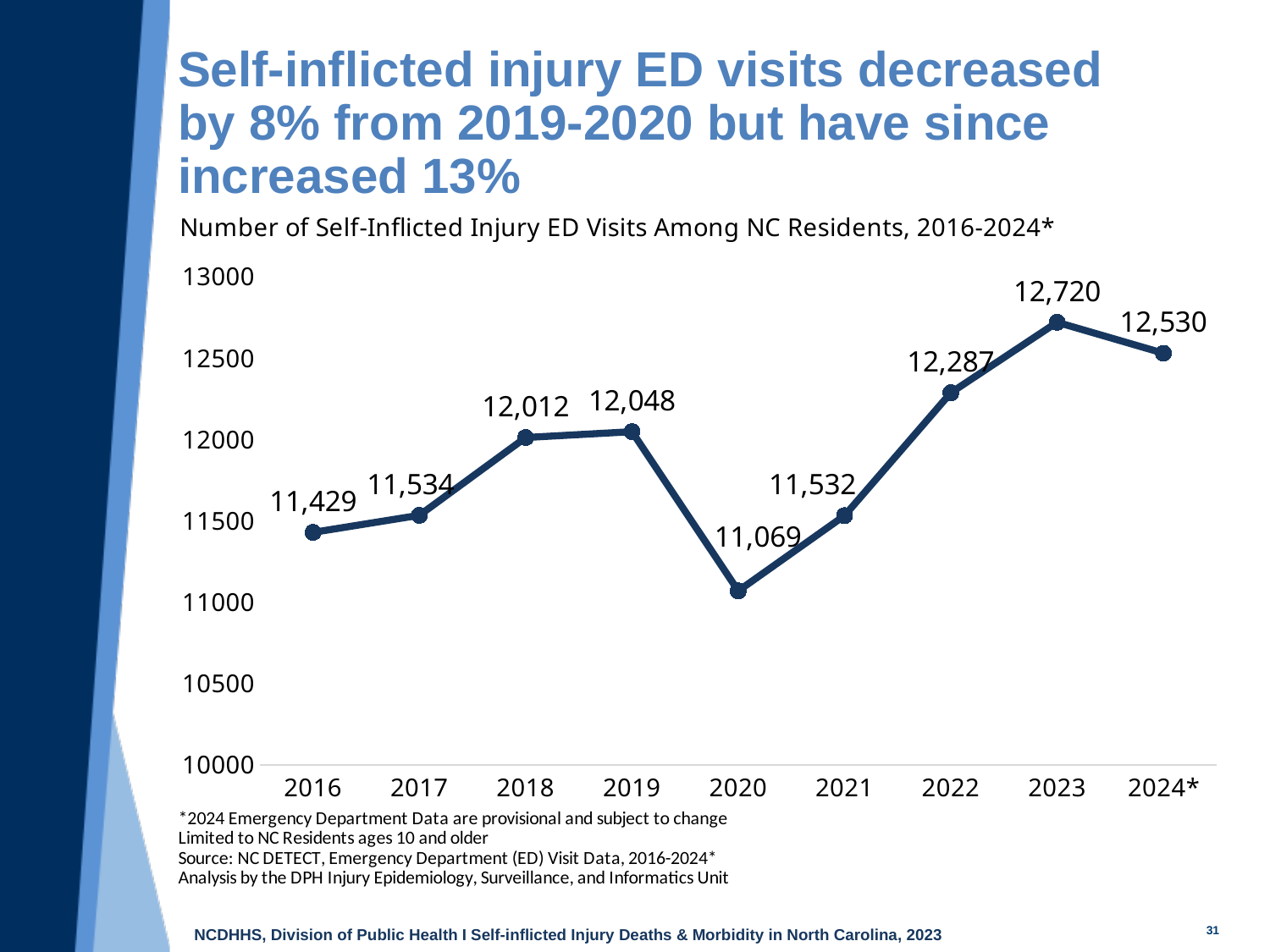
What was the number of self-inflicted injury ED visits in 2016? 11,429 Which year had more self-inflicted injury ED visits, 2018 or 2022? 2022 What type of chart is shown on the slide? Line chart Did the number of self-inflicted injury ED visits rise or fall from 2020 to 2023? Rise Is the value for 2021 greater or less than 12000? less What is the difference in self-inflicted injury ED visits between 2019 and 2020? 979 What is the difference in self-inflicted injury ED visits between 2023 and 2024*? 190 Which year had the highest number of self-inflicted injury ED visits? 2023 What was the number of self-inflicted injury ED visits in 2020? 11,069 Which year had the lowest number of self-inflicted injury ED visits? 2020 How many years are plotted on the chart? 9 What was the number of self-inflicted injury ED visits in 2024*? 12,530